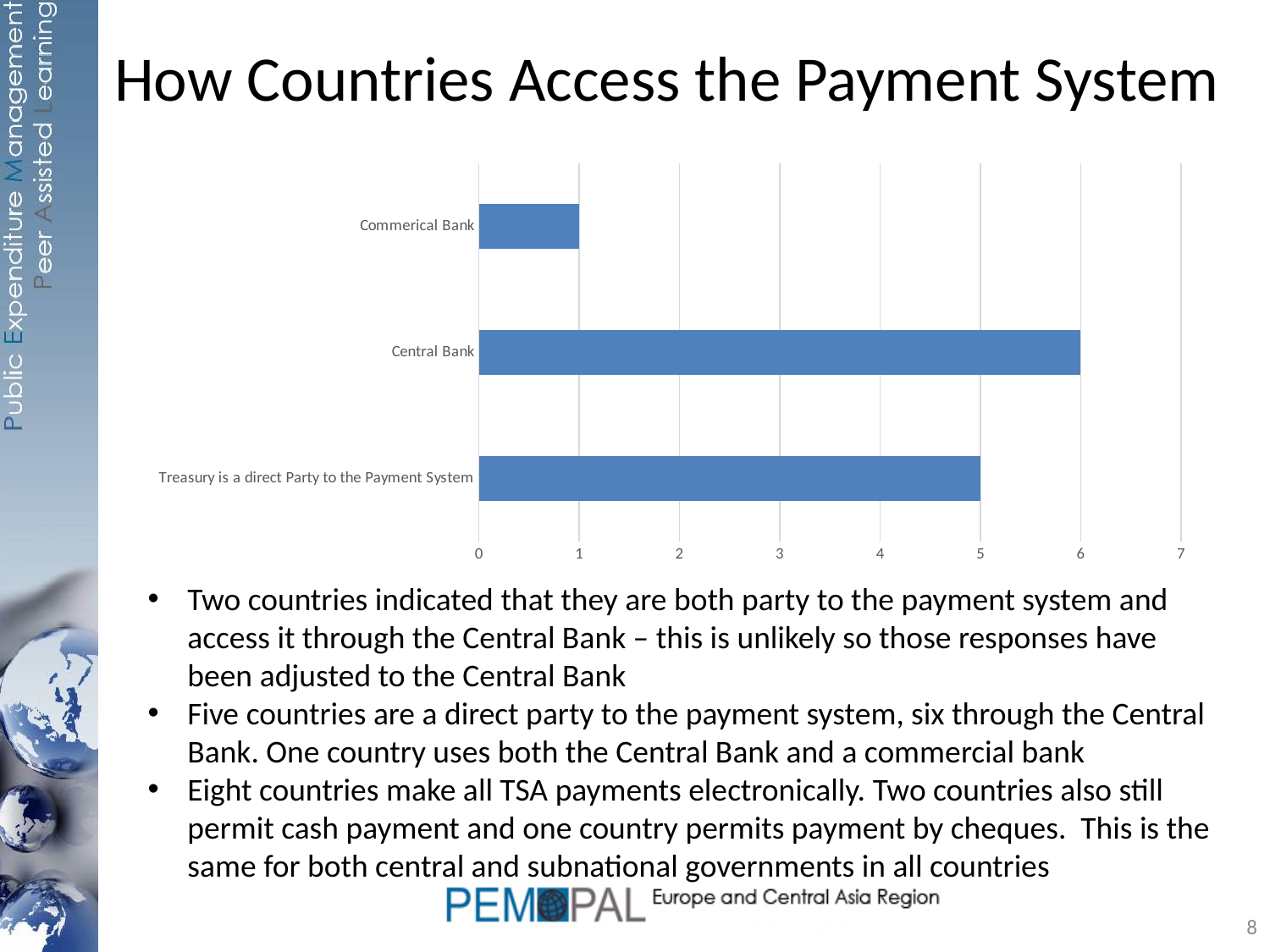
What is the value for Commerical Bank? 1 What is the difference between the values for Central Bank and Commerical Bank? 5 Which category has the highest value? Central Bank What is the difference between the values for Central Bank and Treasury is a direct Party to the Payment System? 1 What is the value for Central Bank? 6 Is the value for Treasury is a direct Party to the Payment System greater or less than 3? greater What is the value for Treasury is a direct Party to the Payment System? 5 How many categories does the chart show? 3 Which category has the lowest value? Commerical Bank What kind of chart is shown on the slide? bar chart What is the highest value shown on the horizontal axis of the chart? 7 Which is larger, the value for Central Bank or the value for Treasury is a direct Party to the Payment System? Central Bank